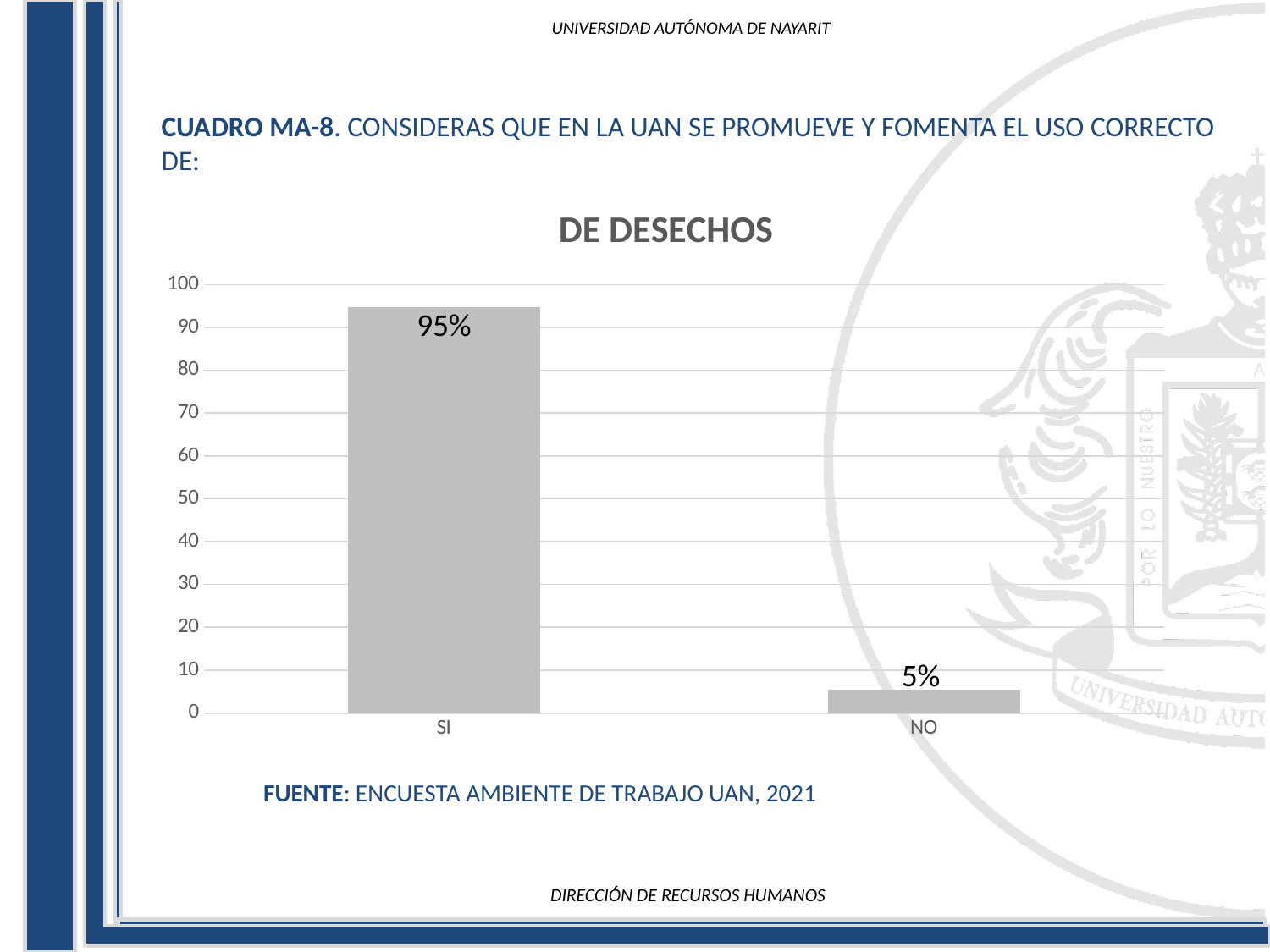
What is the value for SI? 95% What is the difference between the values for SI and NO? 90% What is the value for NO? 5% Which category has the lowest value? NO Which is larger, the value for SI or the value for NO? SI What kind of chart is shown on the slide? bar chart What is the title of the chart? DE DESECHOS Is the value for SI greater or less than 90? greater What is the highest value shown on the y axis? 100 Which category has the highest value? SI How many categories are shown on the x axis? 2 Is the value for NO greater or less than 10? less